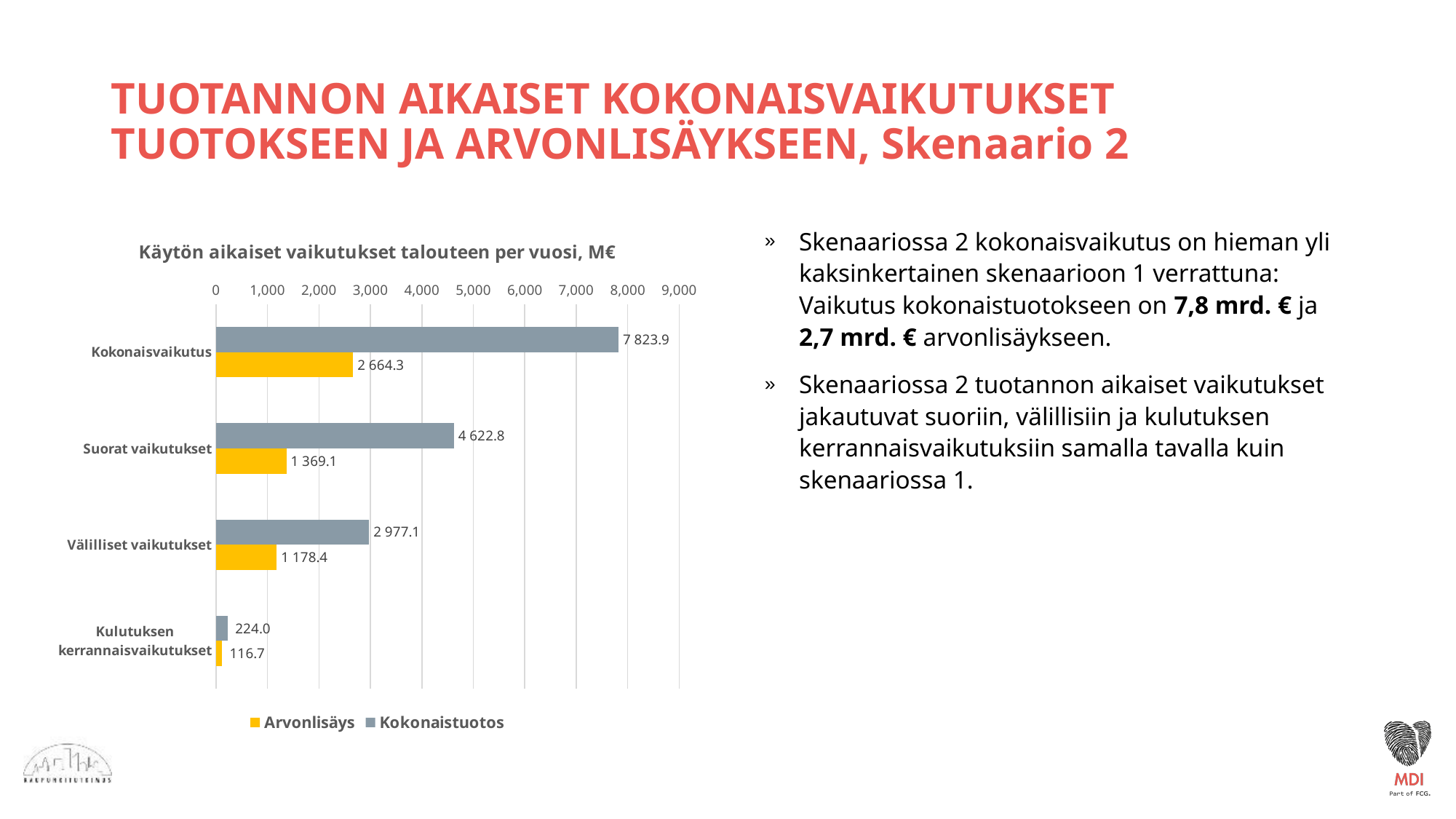
What is the difference between the Kokonaistuotos and Arvonlisäys values for Suorat vaikutukset? 3 253.7 What is the Kokonaistuotos value for Välilliset vaikutukset? 2 977.1 What is the Arvonlisäys value for Suorat vaikutukset? 1 369.1 Which category has the lowest Kokonaistuotos value? Kulutuksen kerrannaisvaikutukset What is the Kokonaistuotos value for Kokonaisvaikutus? 7 823.9 Which category has the highest Arvonlisäys value? Kokonaisvaikutus What type of chart is shown on the slide? Bar chart What is the Arvonlisäys value for Kulutuksen kerrannaisvaikutukset? 116.7 Which is larger: the Arvonlisäys value for Kokonaisvaikutus or the Kokonaistuotos value for Välilliset vaikutukset? Kokonaistuotos value for Välilliset vaikutukset What is the difference between the Kokonaistuotos and Arvonlisäys values for Kulutuksen kerrannaisvaikutukset? 107.3 How many categories are shown on the chart? 4 How many series does the legend list? 2